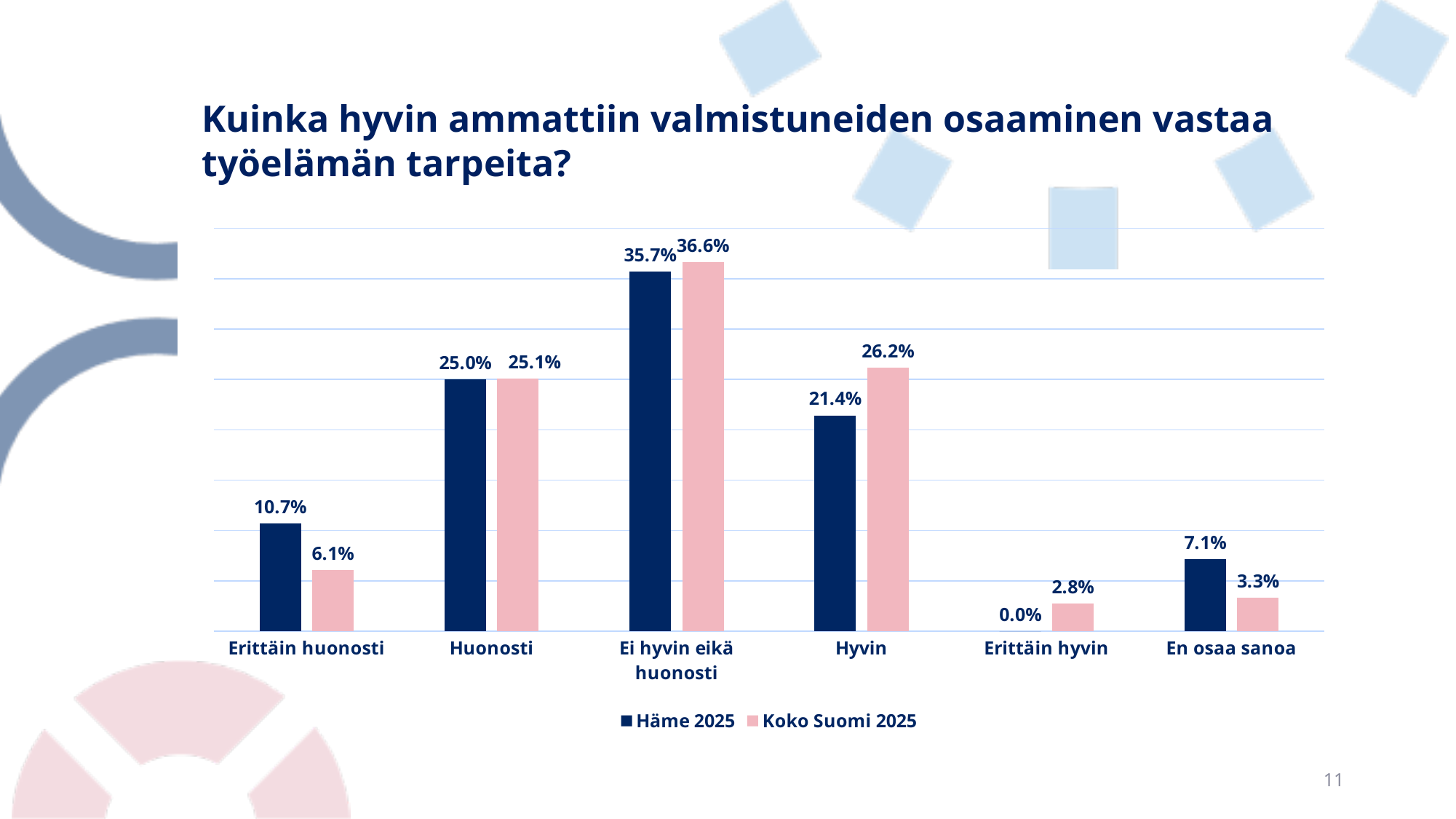
Which category has the highest value for Häme 2025? Ei hyvin eikä huonosti Which category has the lowest value for Häme 2025? Erittäin hyvin What is the value for Häme 2025 in the 'En osaa sanoa' category? 7.1% In the 'Erittäin huonosti' category, which series has the larger value, Häme 2025 or Koko Suomi 2025? Häme 2025 What is the value for Häme 2025 in the 'Erittäin huonosti' category? 10.7% What kind of chart is shown on the slide? Bar chart What is the value for Koko Suomi 2025 in the 'Erittäin hyvin' category? 2.8% What is the difference between the Koko Suomi 2025 and Häme 2025 values in the 'Hyvin' category? 4.8% What is the value for Koko Suomi 2025 in the 'Hyvin' category? 26.2% How many series does the legend list? 2 How many categories are shown on the x axis? 6 Which series is shown in pink in the legend? Koko Suomi 2025